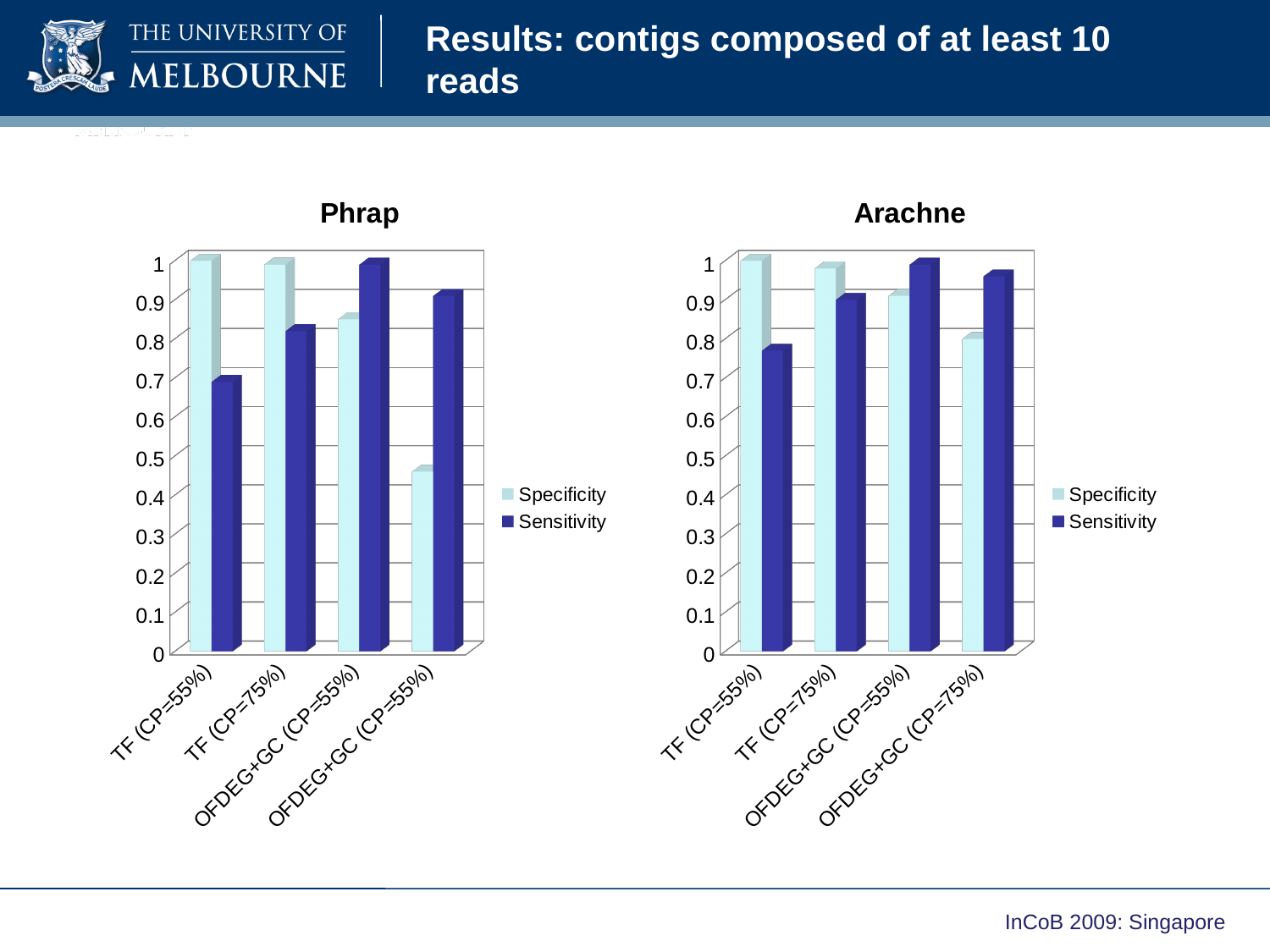
In the Phrap chart, which category has the lowest Sensitivity? TF (CP=55%) In the Phrap chart, for TF (CP=55%), which is larger: Specificity or Sensitivity? Specificity In the Arachne chart, does Specificity rise or fall from left to right across the categories? fall How many categories are shown on the x axis of the Arachne chart? 4 In the Arachne chart, for OFDEG+GC (CP=55%), which is larger: Specificity or Sensitivity? Sensitivity How many series does the legend of the Arachne chart list? 2 In the Arachne chart, which category has the lowest Specificity? OFDEG+GC (CP=75%) What kind of chart is the Phrap chart? bar chart In the Arachne chart, is the Specificity value for OFDEG+GC (CP=75%) greater or less than 0.7? greater In the Arachne chart, which category has the lowest Sensitivity? TF (CP=55%) In the Phrap chart, is the Specificity value for the rightmost category greater or less than 0.5? less